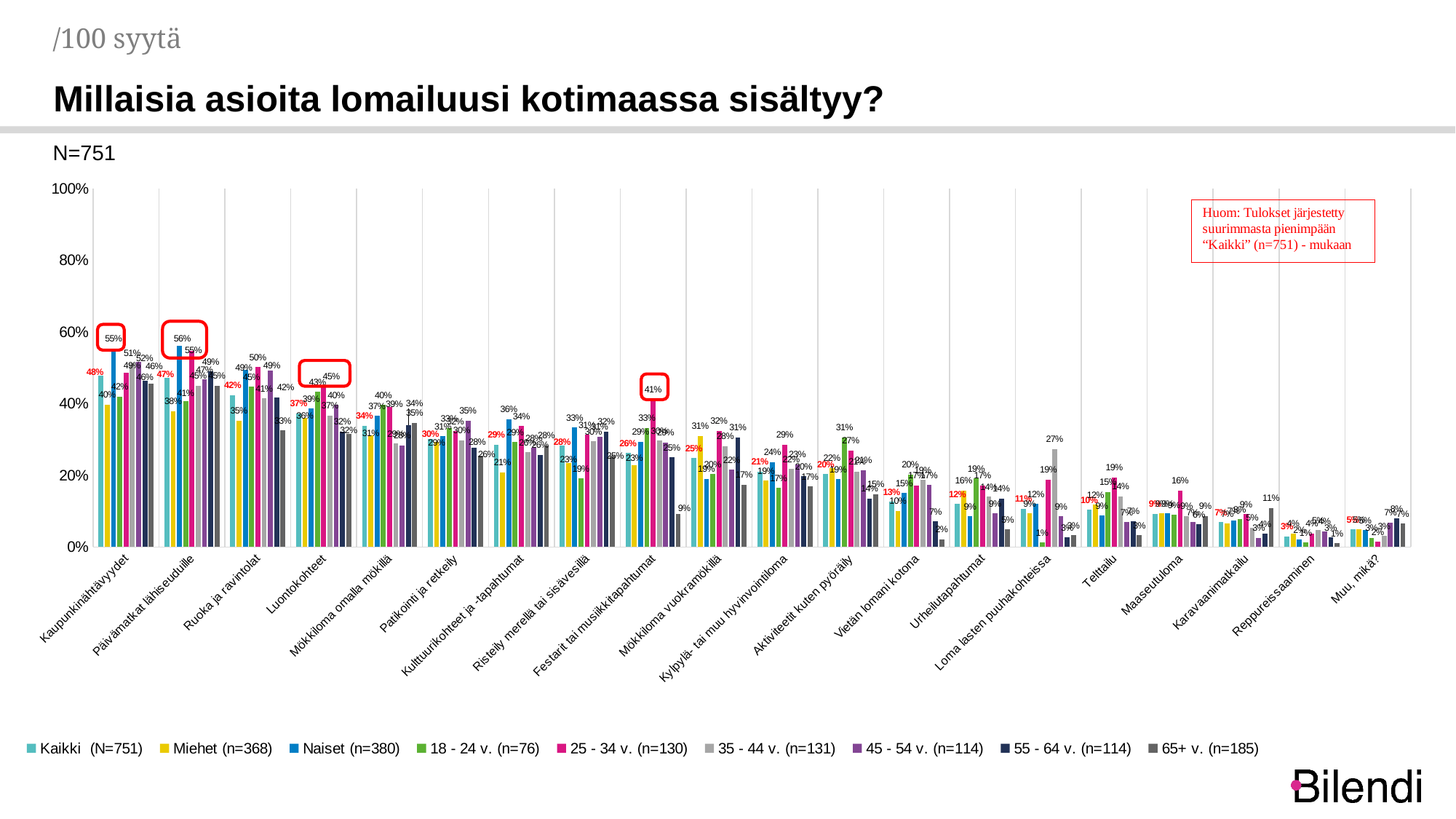
According to the note box on the chart, by which series are the results ordered from largest to smallest? "Kaikki" (n=751) Do the Kaikki (N=751) values rise or fall from left to right along the x axis? fall What kind of chart is shown on the slide? bar chart How many series does the legend list? 9 What is the value for 25 - 34 v. (n=130) for Festarit tai musiikkitapahtumat? 41% For Kaupunkinähtävyydet, what is the difference between the Naiset (n=380) value and the Miehet (n=368) value? 15 percentage points What is the value for Kaikki (N=751) for Kaupunkinähtävyydet? 48% What is the value for Naiset (n=380) for Päivämatkat lähiseudulle? 56% Which category has the lowest value for Kaikki (N=751)? Reppureissaaminen Which category has the highest value for Kaikki (N=751)? Kaupunkinähtävyydet For Kaupunkinähtävyydet, which is larger: the value for Naiset (n=380) or for Miehet (n=368)? Naiset (n=380) How many categories are shown along the x axis? 20